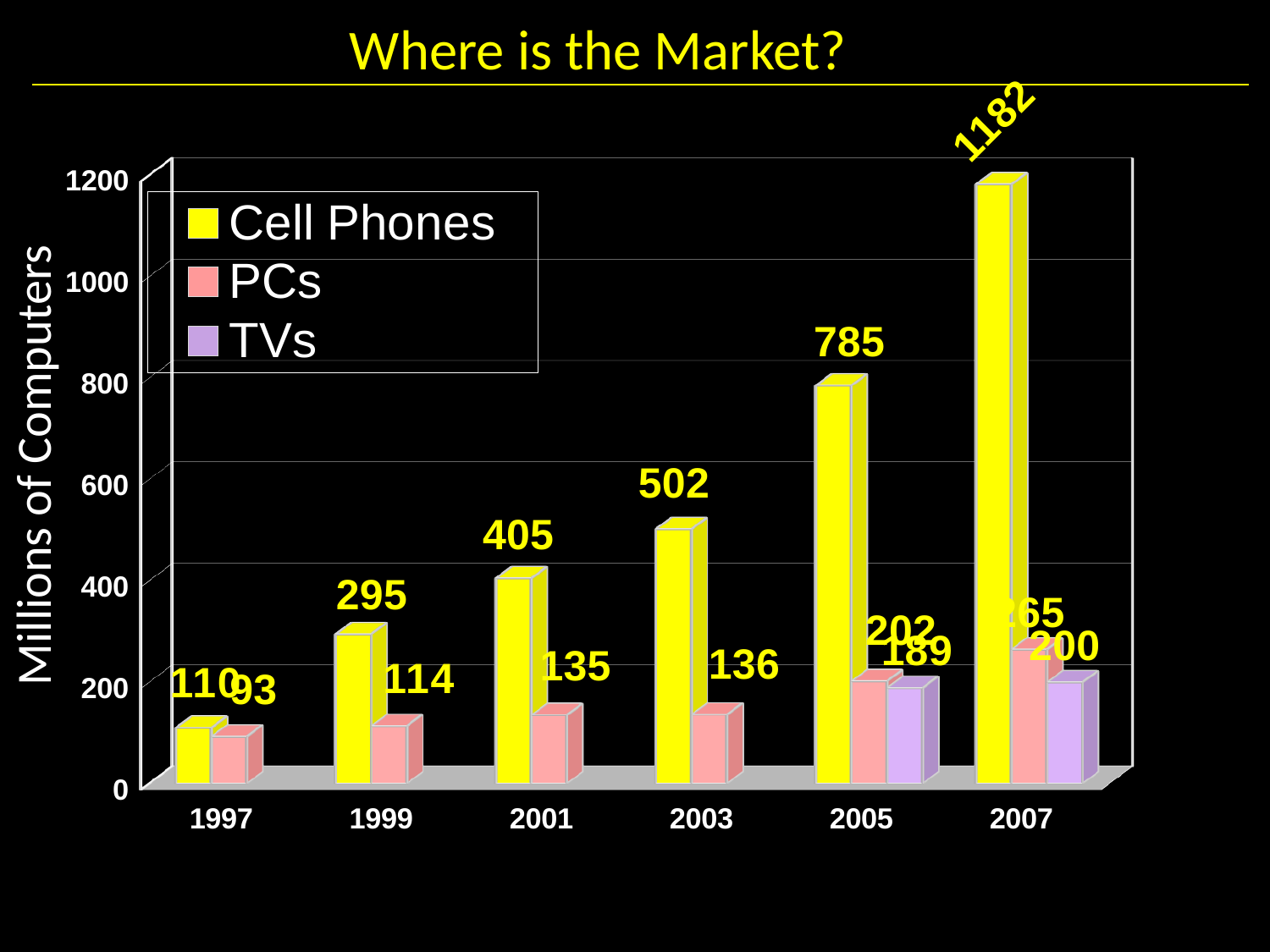
What is the value for PCs in 1999? 114 What is the value for Cell Phones in 2007? 1182 What is the value for TVs in 2005? 189 What is the value for Cell Phones in 2003? 502 Do the Cell Phones values rise or fall from 1997 to 2007? rise In which year is the Cell Phones value lowest? 1997 How many series does the legend list? 3 How many years are shown on the x axis? 6 In 2005, which is larger, PCs or TVs? PCs In which year is the Cell Phones value highest? 2007 Is the value for PCs in 2007 greater or less than 200? greater What is the difference between the Cell Phones values for 2005 and 2003? 283